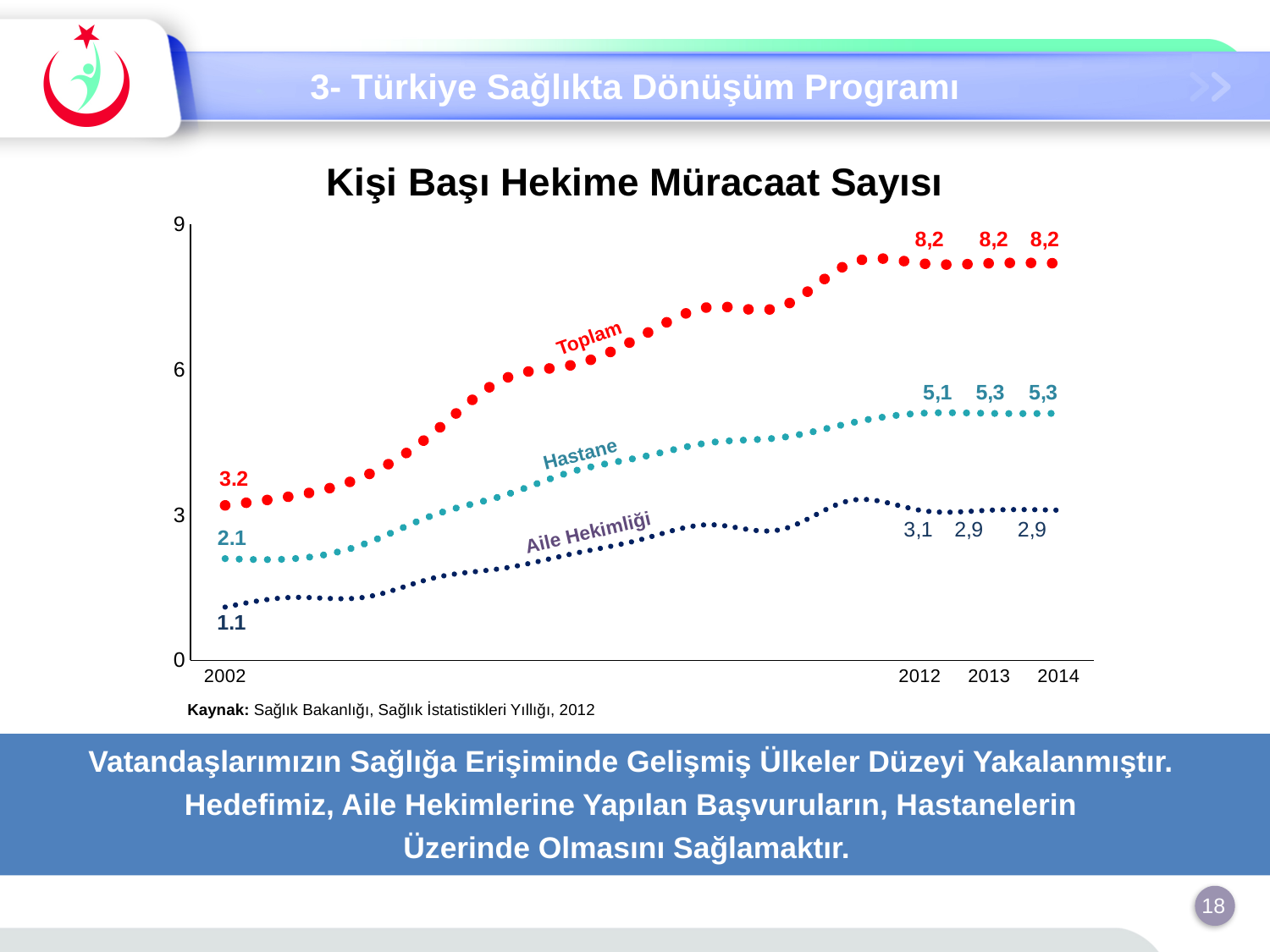
How many series are plotted in the chart? 3 Which series has the highest value in 2014? Toplam What is the title of the chart? Kişi Başı Hekime Müracaat Sayısı What is the value of the Toplam series in 2002? 3.2 What is the value of the Hastane series in 2013? 5,3 What is the value of the Toplam series in 2014? 8,2 What type of chart is shown on the slide? line chart Which series has the lowest value in 2002? Aile Hekimliği What is the difference between the Hastane value in 2014 and the Aile Hekimliği value in 2014? 2,4 Does the Toplam series rise or fall from 2002 to 2012? rise What is the value of the Aile Hekimliği series in 2002? 1.1 What is the value of the Aile Hekimliği series in 2012? 3,1